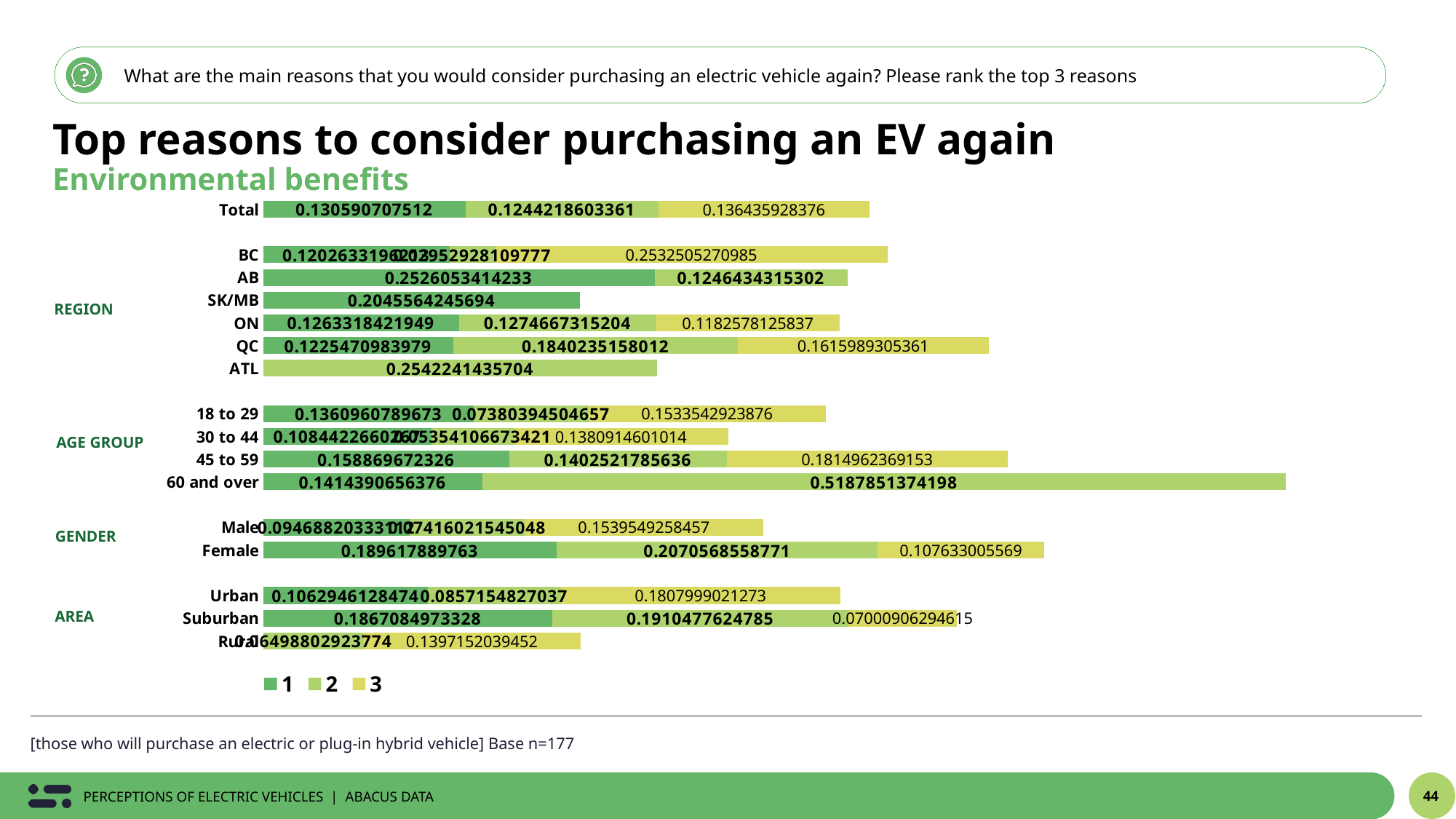
Which category has the longest stacked bar overall? 60 and over What kind of chart is shown? stacked bar chart What is the value of series 3 for Suburban? 0.07000906294615 For AB, which is larger: series 1 or series 2? series 1 How many series does the legend list? 3 What is the value of series 2 for Female? 0.2070568558771 What is the value of series 1 for Total? 0.130590707512 For 45 to 59, which is larger: series 2 or series 3? series 3 How many categories are plotted on the chart? 16 What is the value of series 3 for QC? 0.1615989305361